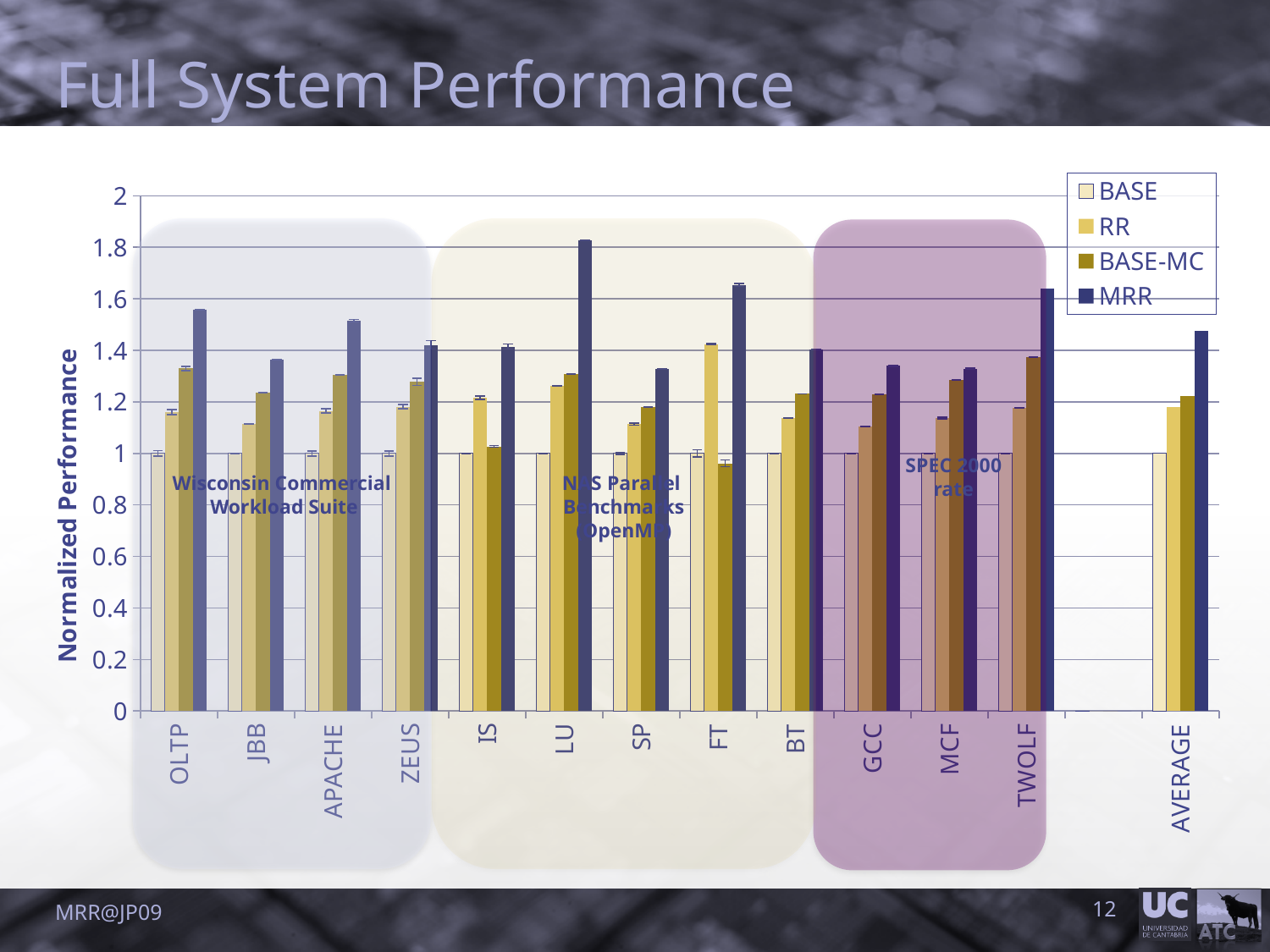
Which series has the highest value for OLTP? MRR How many categories are shown along the x axis? 13 Is the BASE-MC value for FT greater or less than 1? less Which category has the highest MRR value? LU What is the title of the y axis? Normalized Performance How many series does the legend list? 4 Which is larger, the MRR value for LU or the MRR value for SP? MRR value for LU Is the MRR value for LU greater or less than 1.6? greater What is the BASE value for AVERAGE? 1 What is the BASE value for OLTP? 1 What kind of chart is shown on the slide? bar chart Is the RR value for FT greater or less than 1.2? greater